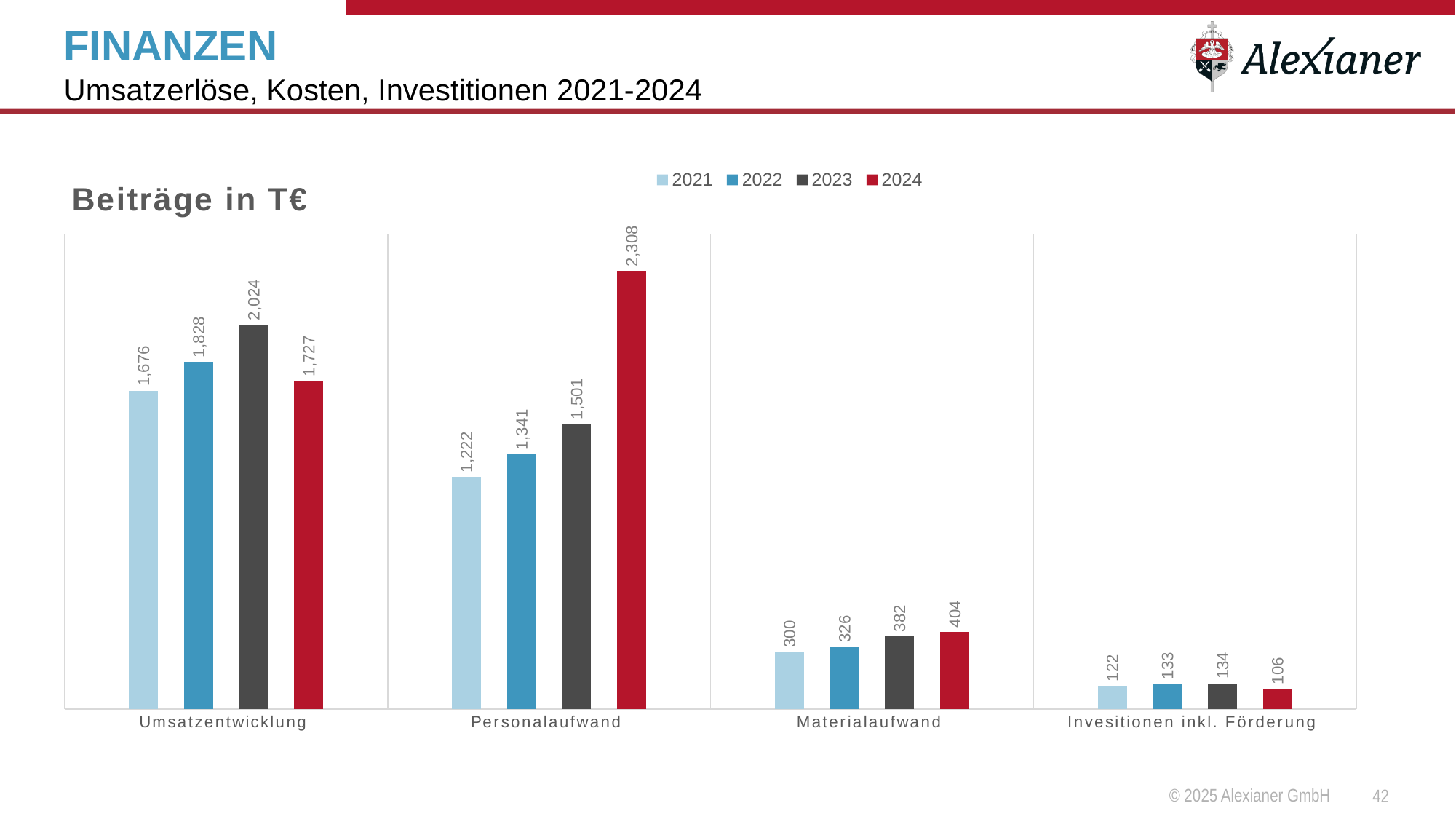
What is the value for Invesitionen inkl. Förderung in 2024? 106 Which is larger for Materialaufwand: the 2022 value or the 2023 value? 2023 What kind of chart is shown on the slide? Bar chart How many series does the legend list? 4 Do the values for Materialaufwand rise or fall from 2021 to 2024? Rise What is the value for Materialaufwand in 2021? 300 Which year has the lowest value for Invesitionen inkl. Förderung? 2024 What is the value for Umsatzentwicklung in 2023? 2,024 What is the difference between the 2024 and 2023 values for Personalaufwand? 807 How many categories are shown on the x axis? 4 Which year has the highest value for Umsatzentwicklung? 2023 What is the value for Personalaufwand in 2024? 2,308